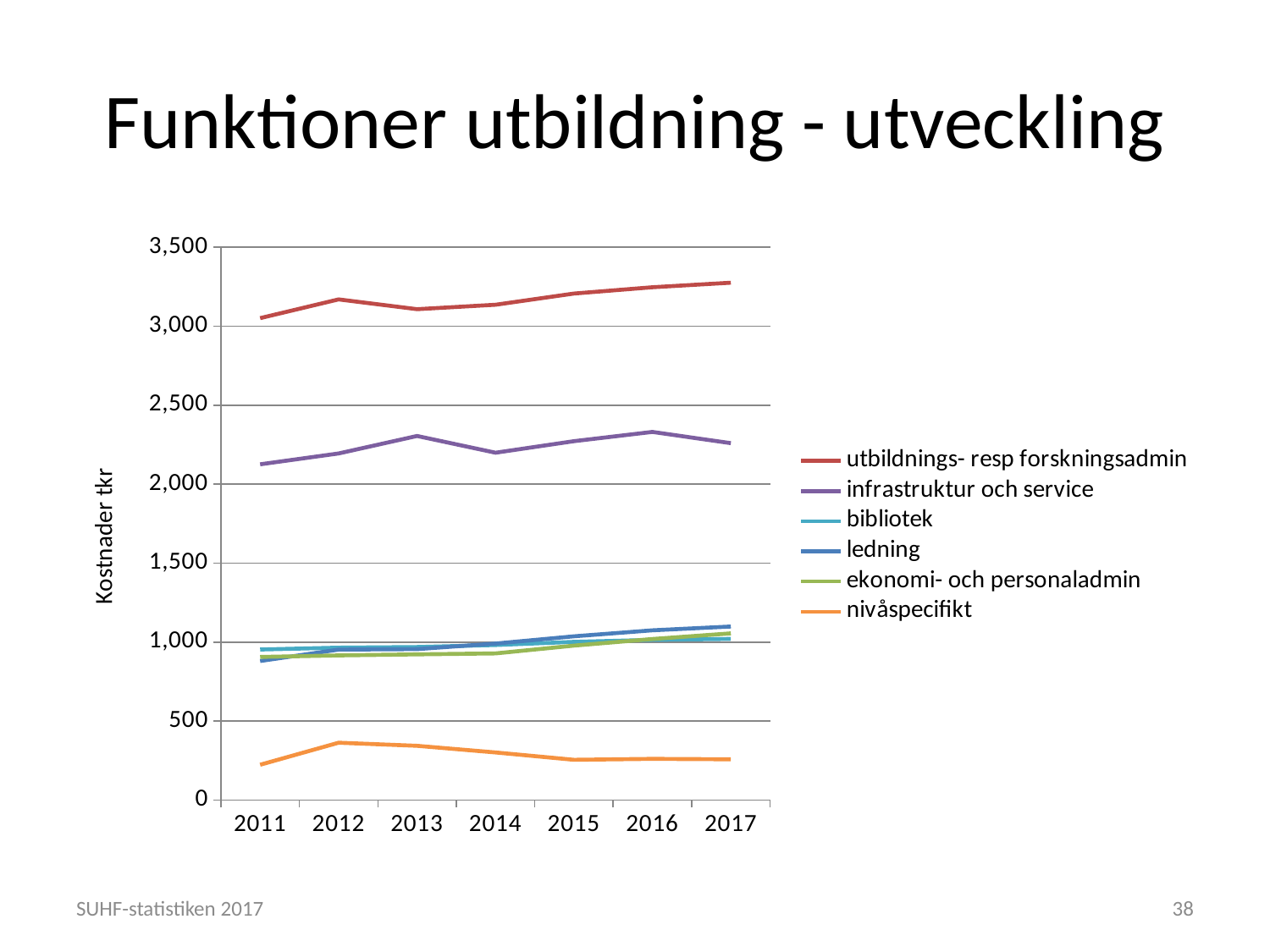
Does the utbildnings- resp forskningsadmin line rise or fall overall from 2011 to 2017? rise What kind of chart is shown on the slide? line chart How many years are shown on the x axis? 7 Which series has the lowest values across all years? nivåspecifikt Which series has the highest values across all years? utbildnings- resp forskningsadmin In 2015, which is larger: infrastruktur och service or nivåspecifikt? infrastruktur och service In which year does the nivåspecifikt line reach its highest value? 2012 Is the value for utbildnings- resp forskningsadmin in 2017 greater or less than 3,000? greater Is the value for nivåspecifikt in 2011 greater or less than 500? less Is the value for infrastruktur och service in 2013 greater or less than 2,000? greater How many series does the legend list? 6 What is the label on the y axis? Kostnader tkr